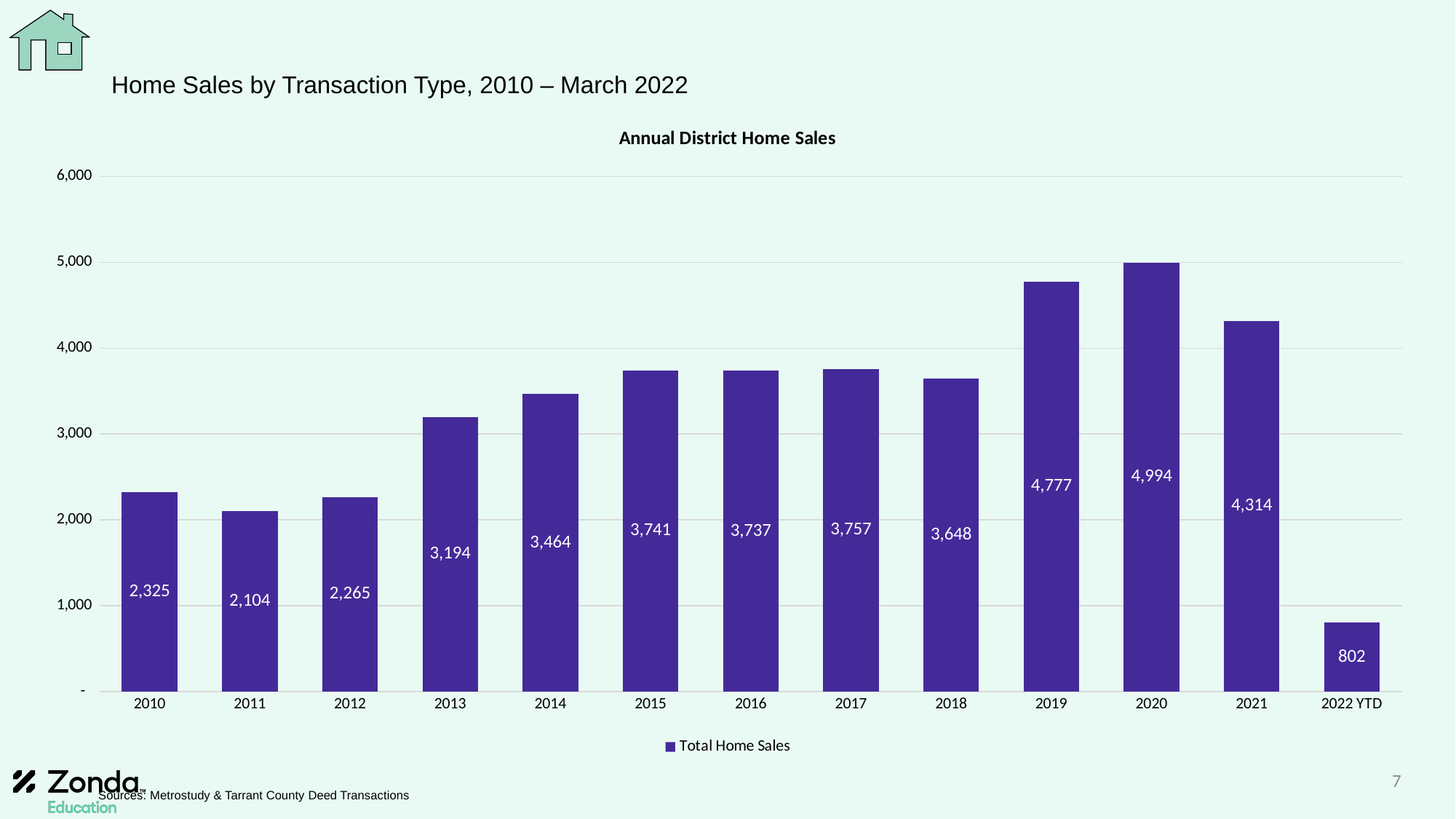
Which is larger, total home sales in 2019 or in 2021? 2019 How many categories are shown on the x axis? 13 What is the value for 2022 YTD in the Annual District Home Sales chart? 802 What kind of chart is shown on the slide? Bar chart What is the value for 2020 in the Annual District Home Sales chart? 4,994 Which year has the highest total home sales? 2020 What is the value for 2013 in the Annual District Home Sales chart? 3,194 Is the value for 2019 greater or less than 4,000? greater Which category has the lowest total home sales? 2022 YTD What is the difference between total home sales in 2010 and 2011? 221 How many series does the legend list? 1 What is the difference between total home sales in 2020 and 2021? 680